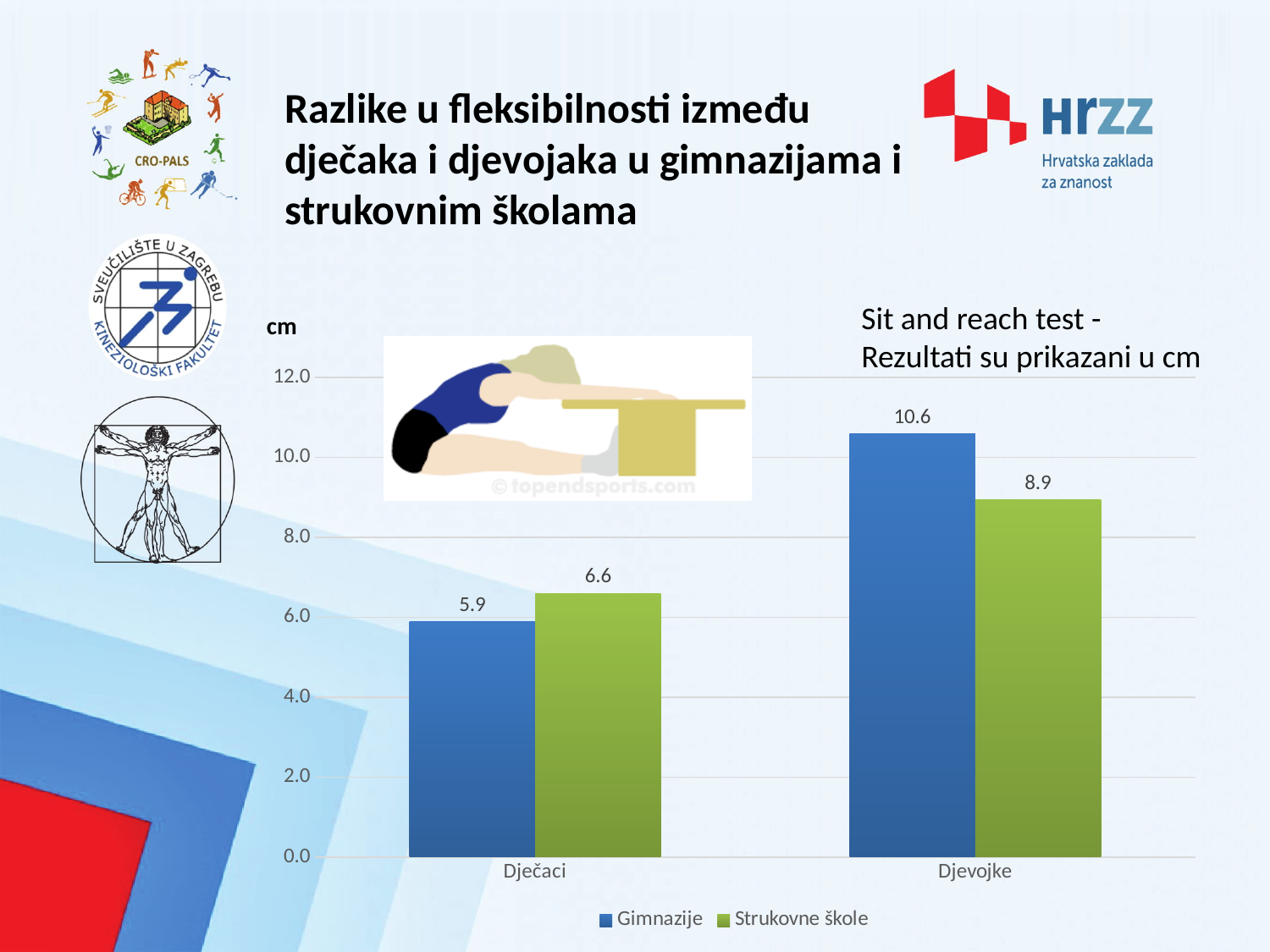
What is the value for Gimnazije in the Djevojke category? 10.6 How many categories are shown on the x axis? 2 What is the difference between the Strukovne škole and Gimnazije values for Dječaci? 0.7 Which is larger for Dječaci: Gimnazije or Strukovne škole? Strukovne škole What is the value for Gimnazije in the Dječaci category? 5.9 What is the value for Strukovne škole in the Djevojke category? 8.9 Which bar has the highest value on the chart? Gimnazije, Djevojke What is the difference between the Gimnazije and Strukovne škole values for Djevojke? 1.7 What kind of chart is shown on the slide? Bar chart What is the value for Strukovne škole in the Dječaci category? 6.6 How many series does the legend list? 2 Which bar has the lowest value on the chart? Gimnazije, Dječaci